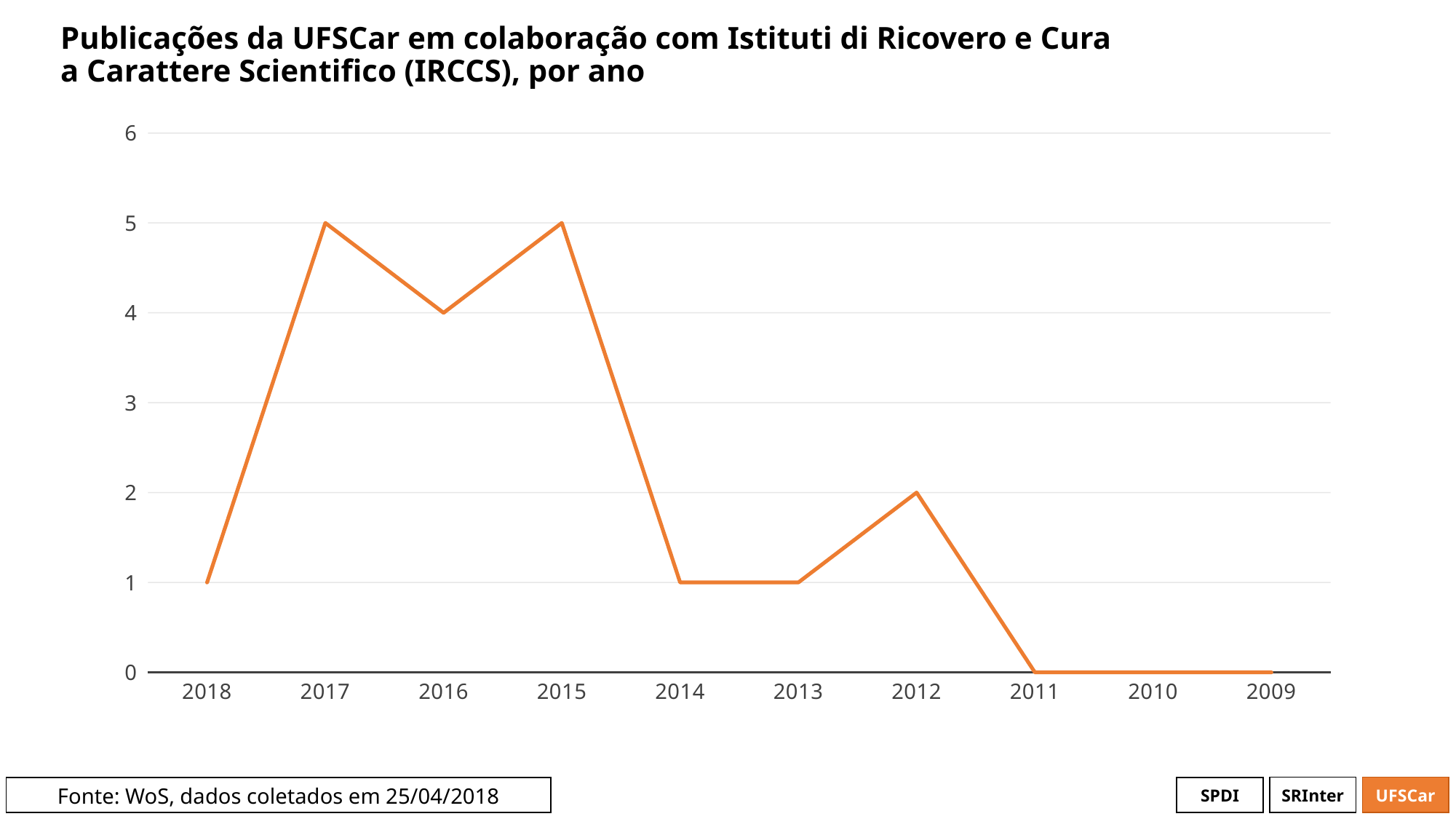
What type of chart is shown on the slide? line chart What is the data source cited at the bottom of the slide? WoS, dados coletados em 25/04/2018 What is the number of publications for 2012? 2 Which year has the larger value, 2016 or 2012? 2016 What is the number of publications for 2018? 1 What is the number of publications for 2017? 5 How many years are plotted on the x axis? 10 What is the number of publications for 2016? 4 What is the difference between the values for 2015 and 2014? 4 What is the difference between the values for 2017 and 2016? 1 What is the number of publications for 2010? 0 Is the value for 2015 greater or less than 3? greater